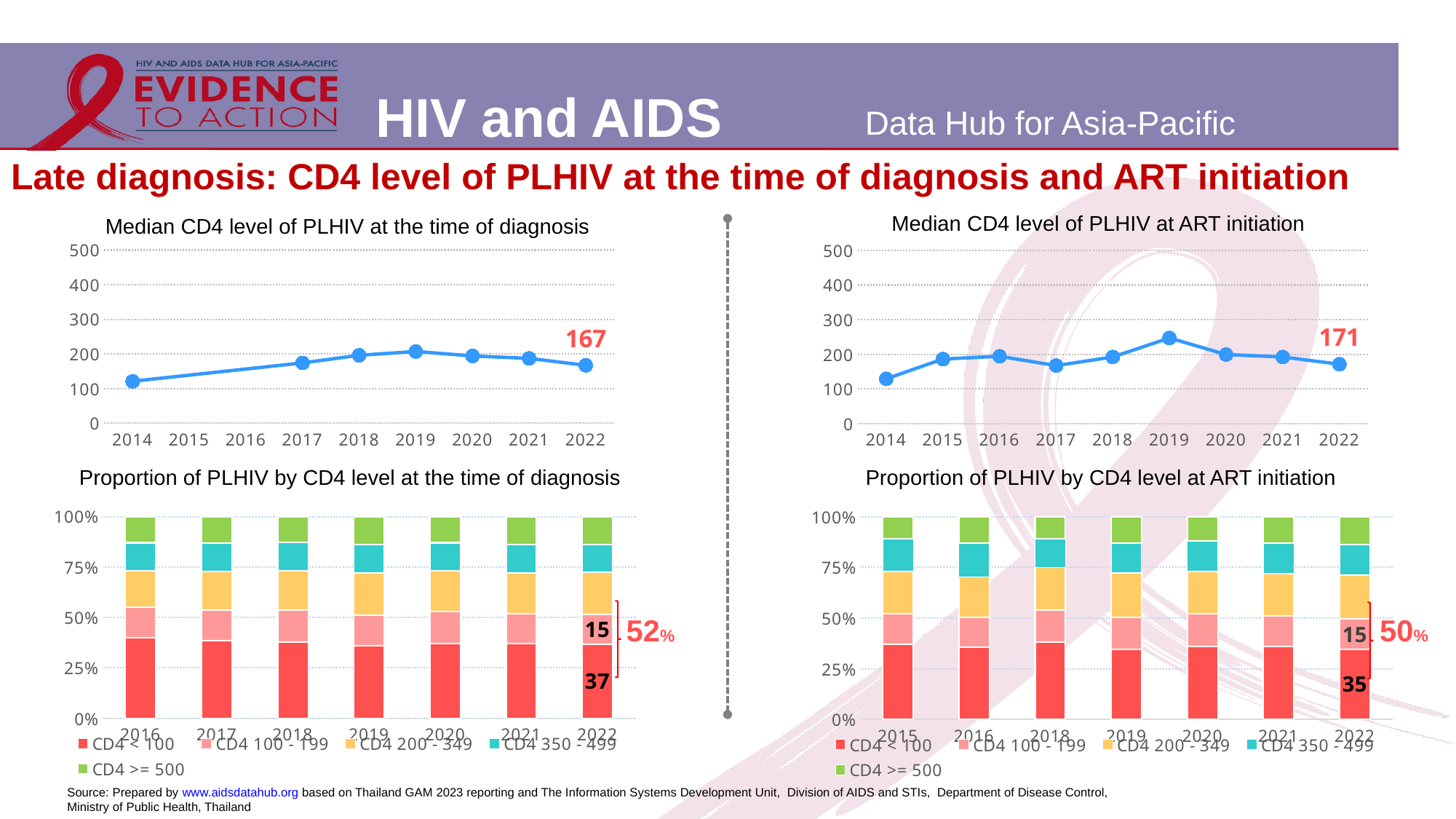
In the 'Median CD4 level of PLHIV at the time of diagnosis' chart, how many years are plotted? 7 What is the difference between the 2022 median CD4 level at ART initiation and the 2022 median CD4 level at the time of diagnosis? 4 In the 'Median CD4 level of PLHIV at ART initiation' chart, what is the value for 2022? 171 What kind of chart is 'Median CD4 level of PLHIV at ART initiation'? Line chart In the 'Proportion of PLHIV by CD4 level at ART initiation' chart, what is the labelled value for CD4 100 - 199 in 2022? 15 In the 'Proportion of PLHIV by CD4 level at ART initiation' chart, how many years (bars) are shown? 7 In the 'Median CD4 level of PLHIV at ART initiation' chart, which year has the highest value? 2019 In the 'Proportion of PLHIV by CD4 level at the time of diagnosis' chart, what is the labelled value for CD4 < 100 in 2022? 37 In the 'Median CD4 level of PLHIV at the time of diagnosis' chart, is the value for 2014 greater or less than 100? greater Comparing the two top line charts, which is larger for 2022: the median CD4 level at the time of diagnosis or at ART initiation? At ART initiation How many series does the legend list in the 'Proportion of PLHIV by CD4 level at the time of diagnosis' chart? 5 In the 'Median CD4 level of PLHIV at the time of diagnosis' chart, what is the value for 2022? 167